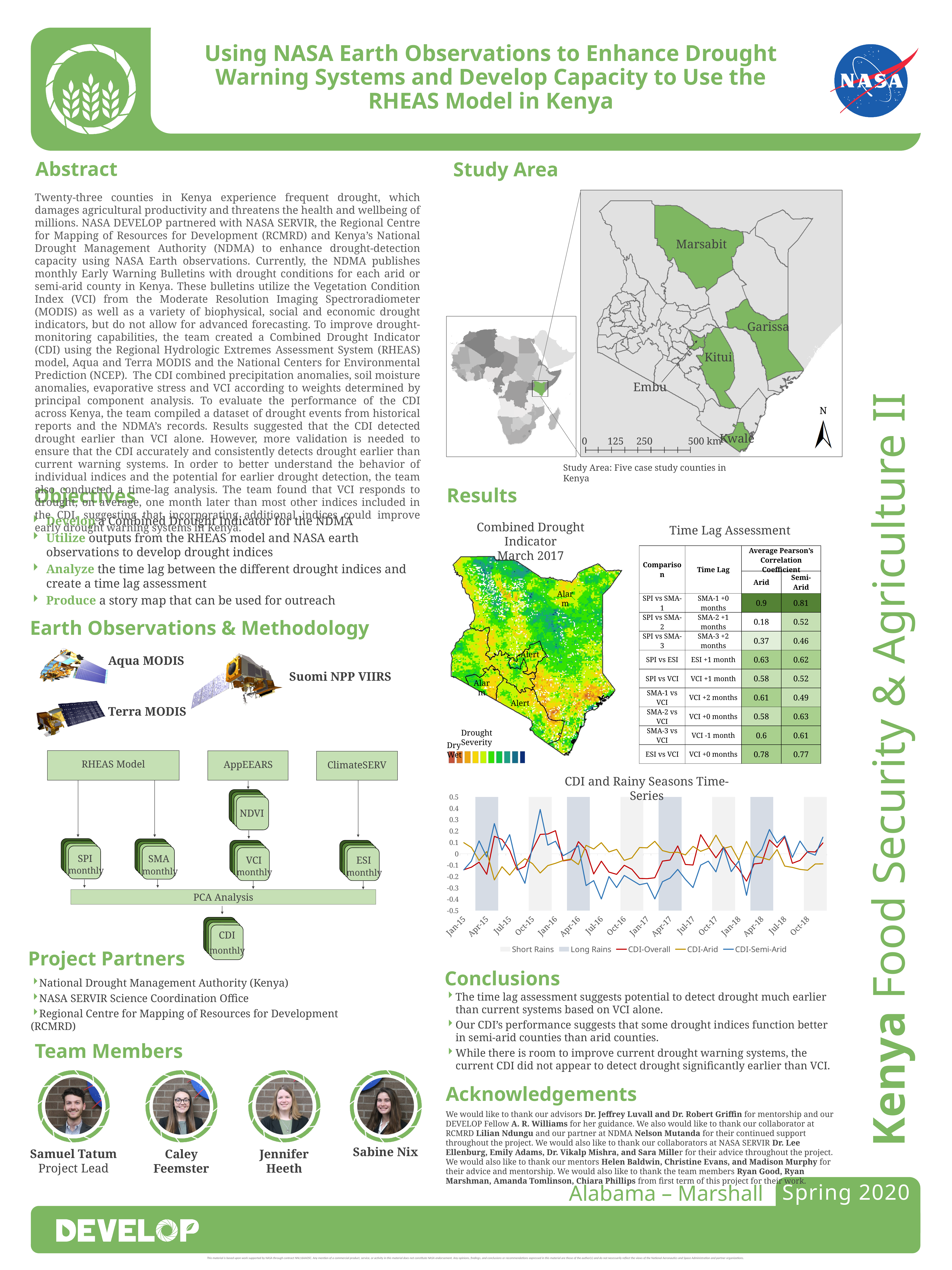
In the 'CDI and Rainy Seasons Time-Series' chart, is the highest value of the CDI-Arid line greater or less than 0.2? less In the 'CDI and Rainy Seasons Time-Series' chart, is the highest value of the CDI-Semi-Arid line greater or less than 0.3? greater In the 'CDI and Rainy Seasons Time-Series' chart, is the lowest value of the CDI-Semi-Arid line greater or less than -0.3? less What kind of chart is the 'CDI and Rainy Seasons Time-Series' chart? line chart How many CDI line series are plotted in the 'CDI and Rainy Seasons Time-Series' chart? 3 In the 'CDI and Rainy Seasons Time-Series' chart, what colour is the CDI-Overall line? red In the 'CDI and Rainy Seasons Time-Series' chart, which series has the larger peak value: CDI-Semi-Arid or CDI-Arid? CDI-Semi-Arid What is the title of the line chart in the Results section? CDI and Rainy Seasons Time-Series How many x-axis tick labels are shown on the 'CDI and Rainy Seasons Time-Series' chart? 16 In the 'CDI and Rainy Seasons Time-Series' chart, which series reaches the lowest value on the chart? CDI-Semi-Arid How many entries does the legend of the 'CDI and Rainy Seasons Time-Series' chart list? 5